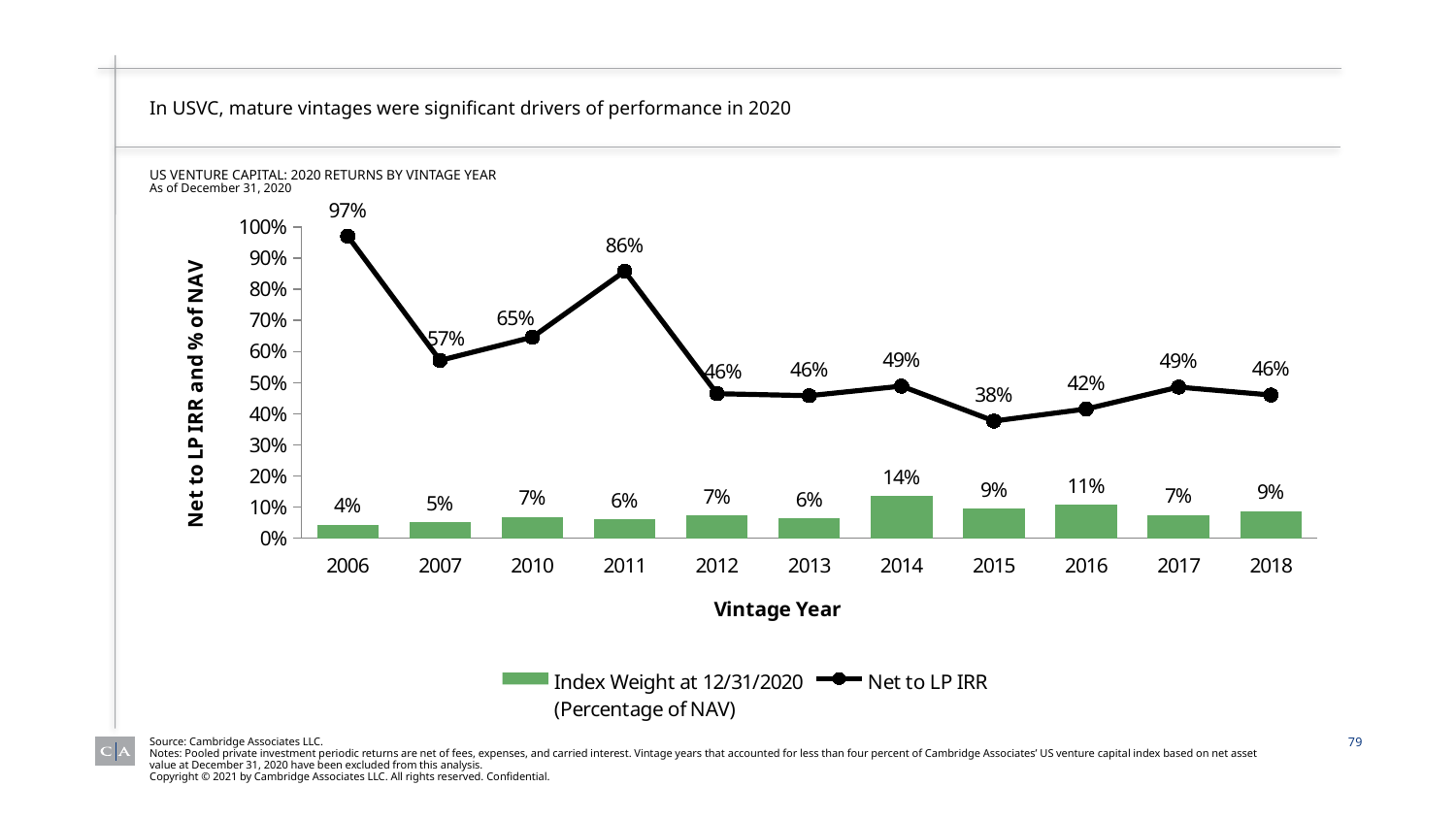
What is the Net to LP IRR for the 2015 vintage year? 38% Which vintage year has the lowest Net to LP IRR? 2015 Which is larger, the Net to LP IRR for 2011 or for 2010? 2011 Which vintage year has the highest Net to LP IRR? 2006 What is the difference between the Net to LP IRR for 2006 and 2007? 40% What kind of chart is shown on the slide? Combined bar and line chart What is the Index Weight at 12/31/2020 for the 2014 vintage year? 14% What is the title of the chart? US VENTURE CAPITAL: 2020 RETURNS BY VINTAGE YEAR What is the Net to LP IRR for the 2006 vintage year? 97% Which vintage year has the highest Index Weight at 12/31/2020? 2014 How many vintage years are shown on the x axis? 11 How many series does the legend list? 2